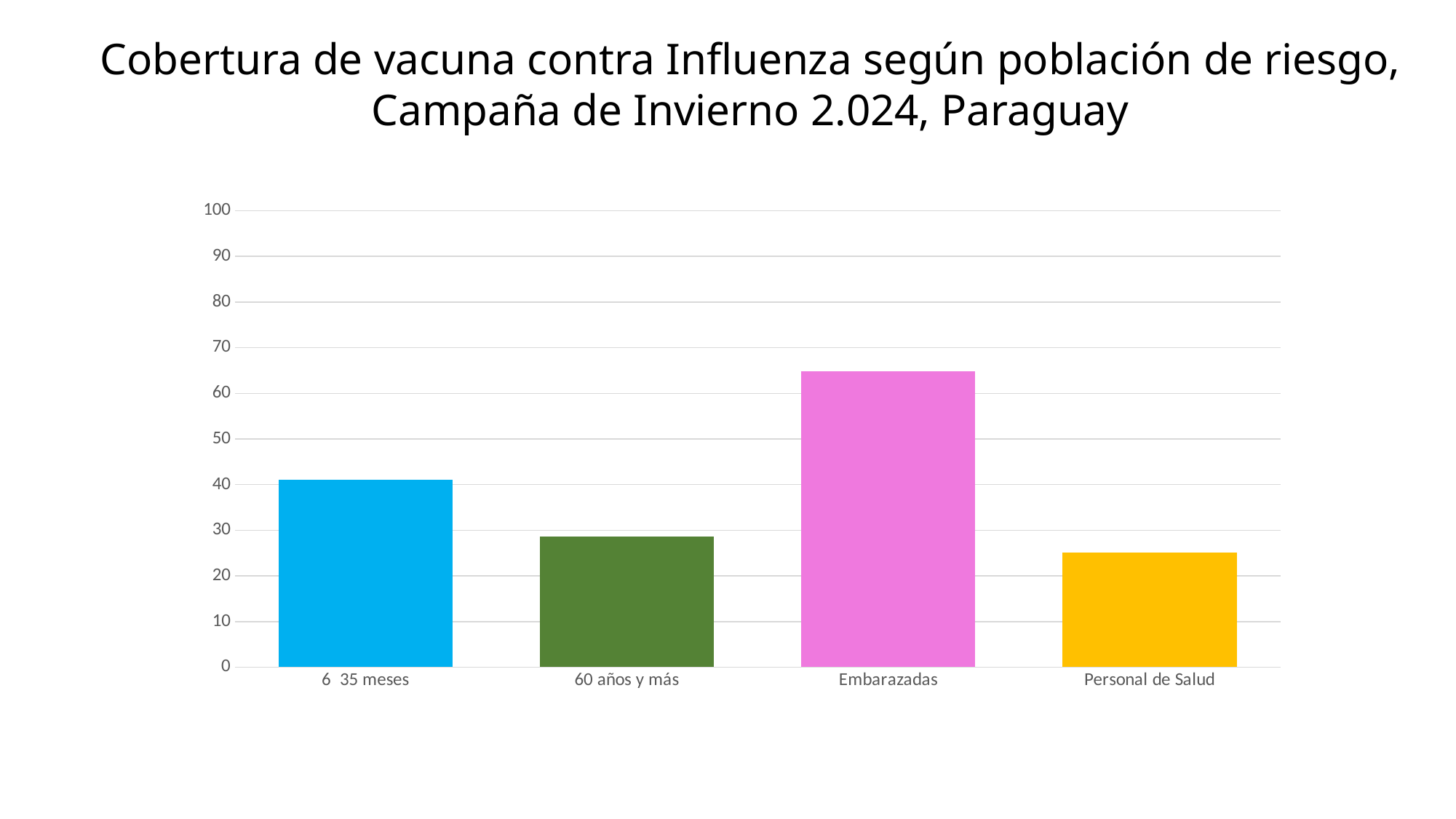
Which is larger, the value for 6 35 meses or the value for 60 años y más? 6 35 meses Is the value for Personal de Salud greater or less than 30? less What colour is the bar for Embarazadas? pink Which category has the lowest vaccine coverage? Personal de Salud What kind of chart is shown on the slide? bar chart Which category has the highest vaccine coverage? Embarazadas How many risk population categories are shown on the x axis? 4 What is the title of the slide? Cobertura de vacuna contra Influenza según población de riesgo, Campaña de Invierno 2.024, Paraguay Is the value for 6 35 meses greater or less than 30? greater Is the value for 60 años y más greater or less than 40? less Which is larger, the value for Embarazadas or the value for Personal de Salud? Embarazadas